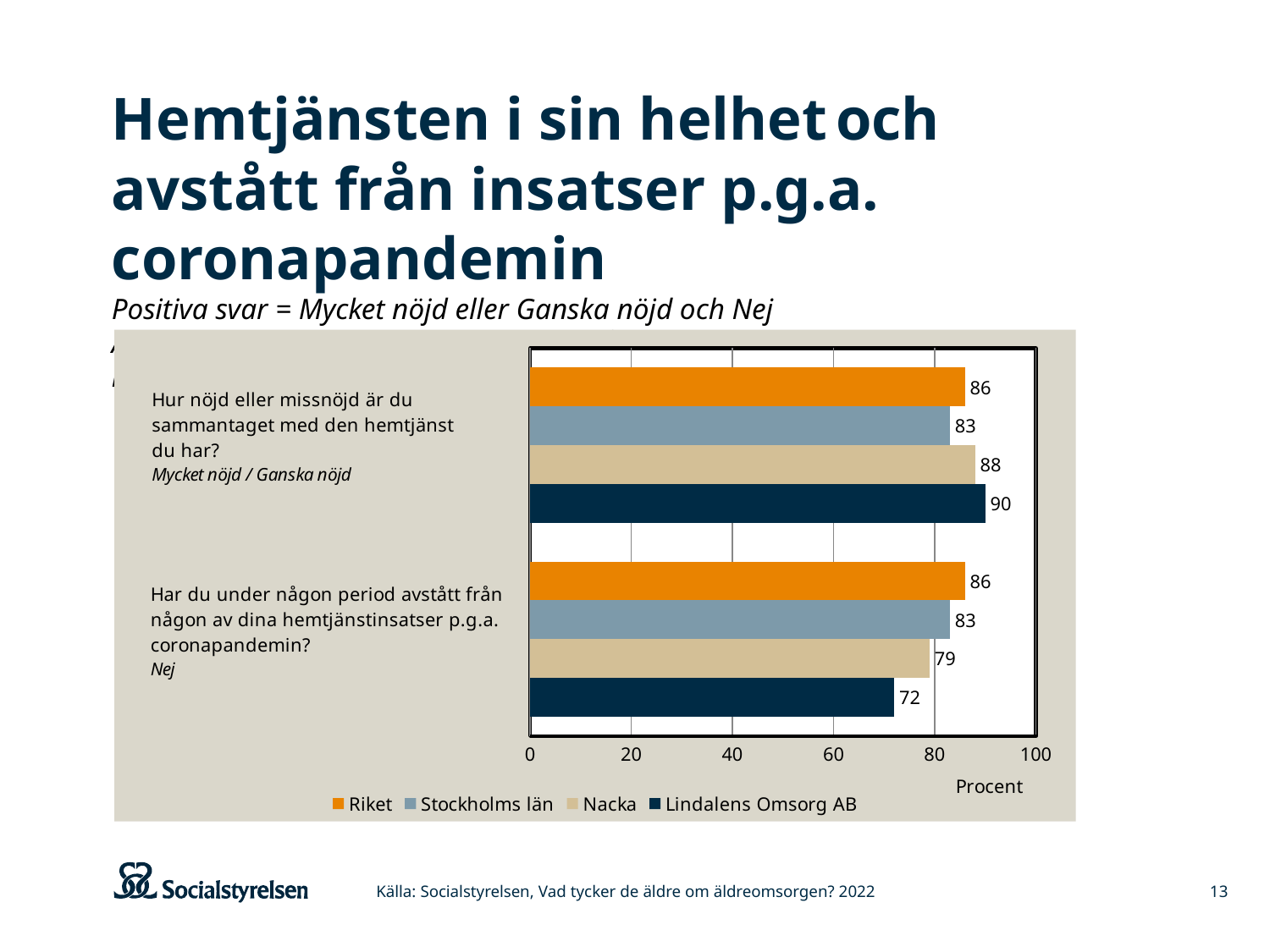
What unit is shown on the x axis of the chart? Procent For the question "Har du under någon period avstått från någon av dina hemtjänstinsatser p.g.a. coronapandemin?", which is larger: the value for Riket or the value for Nacka? Riket What is the difference between the Riket value and the Lindalens Omsorg AB value for the question "Har du under någon period avstått från någon av dina hemtjänstinsatser p.g.a. coronapandemin?"? 14 What is the value for Lindalens Omsorg AB for the question "Hur nöjd eller missnöjd är du sammantaget med den hemtjänst du har?"? 90 What is the value for Stockholms län for the question "Hur nöjd eller missnöjd är du sammantaget med den hemtjänst du har?"? 83 How many series does the legend list? 4 Which series has the lowest value for the question "Har du under någon period avstått från någon av dina hemtjänstinsatser p.g.a. coronapandemin?"? Lindalens Omsorg AB Which series has the highest value for the question "Hur nöjd eller missnöjd är du sammantaget med den hemtjänst du har?"? Lindalens Omsorg AB What kind of chart is shown on the slide? Bar chart What is the difference between the Lindalens Omsorg AB value and the Nacka value for the question "Hur nöjd eller missnöjd är du sammantaget med den hemtjänst du har?"? 2 How many question categories are shown on the chart? 2 What is the value for Nacka for the question "Har du under någon period avstått från någon av dina hemtjänstinsatser p.g.a. coronapandemin?"? 79